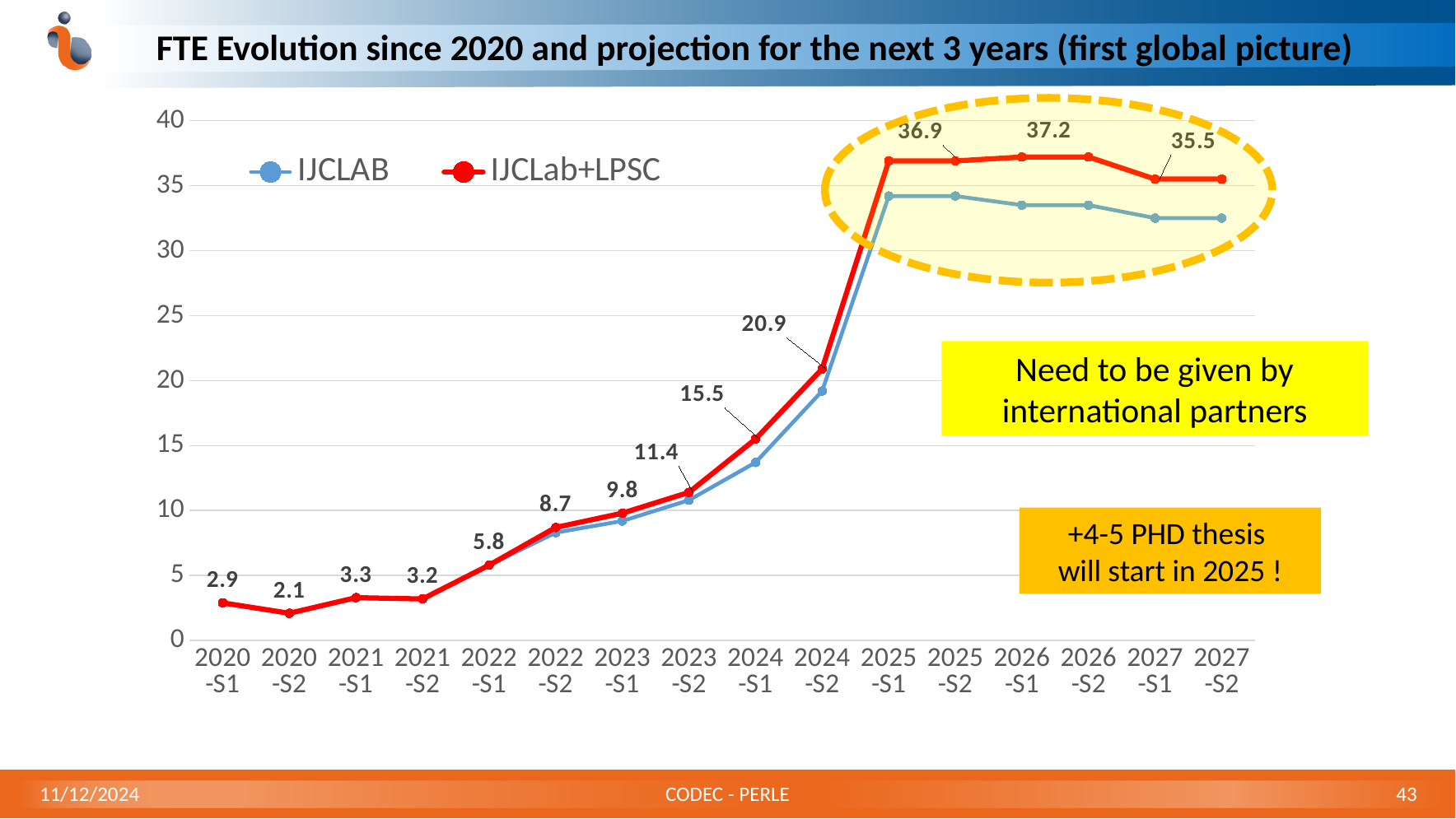
What is the IJCLab+LPSC value for 2023-S2? 11.4 What is the IJCLab+LPSC value for 2020-S1? 2.9 Is the IJCLAB value for 2025-S1 greater or less than 30? greater How many time points are shown on the x axis? 16 What type of chart is shown on the slide? line chart How many series does the legend list? 2 At which time point is the IJCLab+LPSC value lowest? 2020-S2 What is the IJCLab+LPSC value for 2022-S2? 8.7 Which is larger for IJCLab+LPSC: the value for 2021-S1 or the value for 2022-S1? 2022-S1 What is the IJCLab+LPSC value for 2024-S2? 20.9 Do the values rise or fall from 2021-S2 to 2025-S1? rise What is the difference between the IJCLab+LPSC values for 2024-S2 and 2024-S1? 5.4